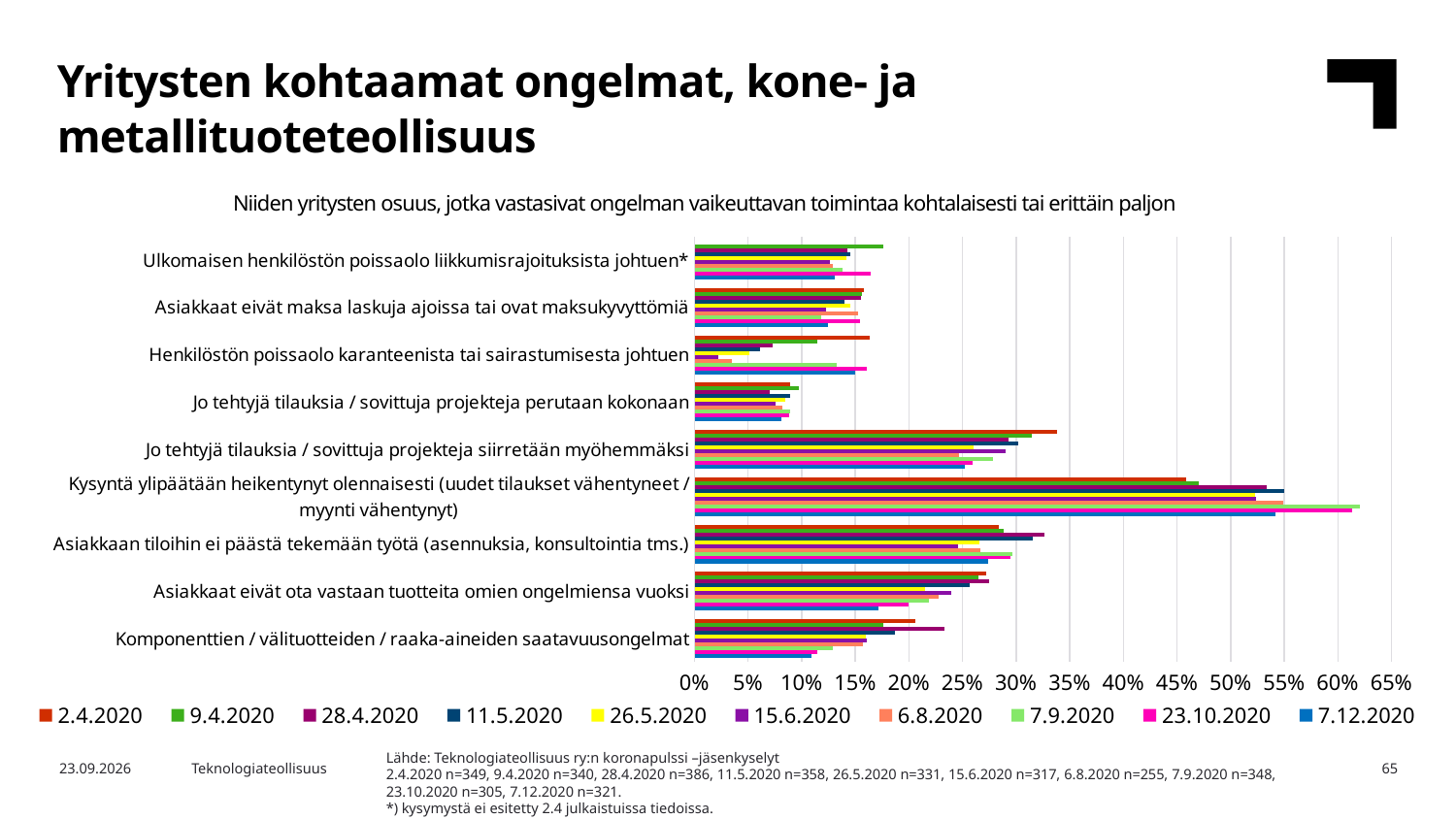
Is the 2.4.2020 value for 'Jo tehtyjä tilauksia / sovittuja projekteja siirretään myöhemmäksi' greater or less than 30%? greater Which category has the lowest values overall on the chart? Jo tehtyjä tilauksia / sovittuja projekteja perutaan kokonaan How many series (survey dates) does the legend list? 10 Is the 7.9.2020 value for 'Kysyntä ylipäätään heikentynyt olennaisesti' greater or less than 55%? greater Which category has the highest values overall on the chart? Kysyntä ylipäätään heikentynyt olennaisesti (uudet tilaukset vähentyneet / myynti vähentynyt) How many categories (problem types) are listed on the chart? 9 What is the highest tick value shown on the x axis? 65% What kind of chart is shown on the slide? Bar chart For 2.4.2020, which is larger: 'Jo tehtyjä tilauksia / sovittuja projekteja siirretään myöhemmäksi' or 'Jo tehtyjä tilauksia / sovittuja projekteja perutaan kokonaan'? Jo tehtyjä tilauksia / sovittuja projekteja siirretään myöhemmäksi Is the 2.4.2020 value for 'Kysyntä ylipäätään heikentynyt olennaisesti' greater or less than 40%? greater What is the first series listed in the legend? 2.4.2020